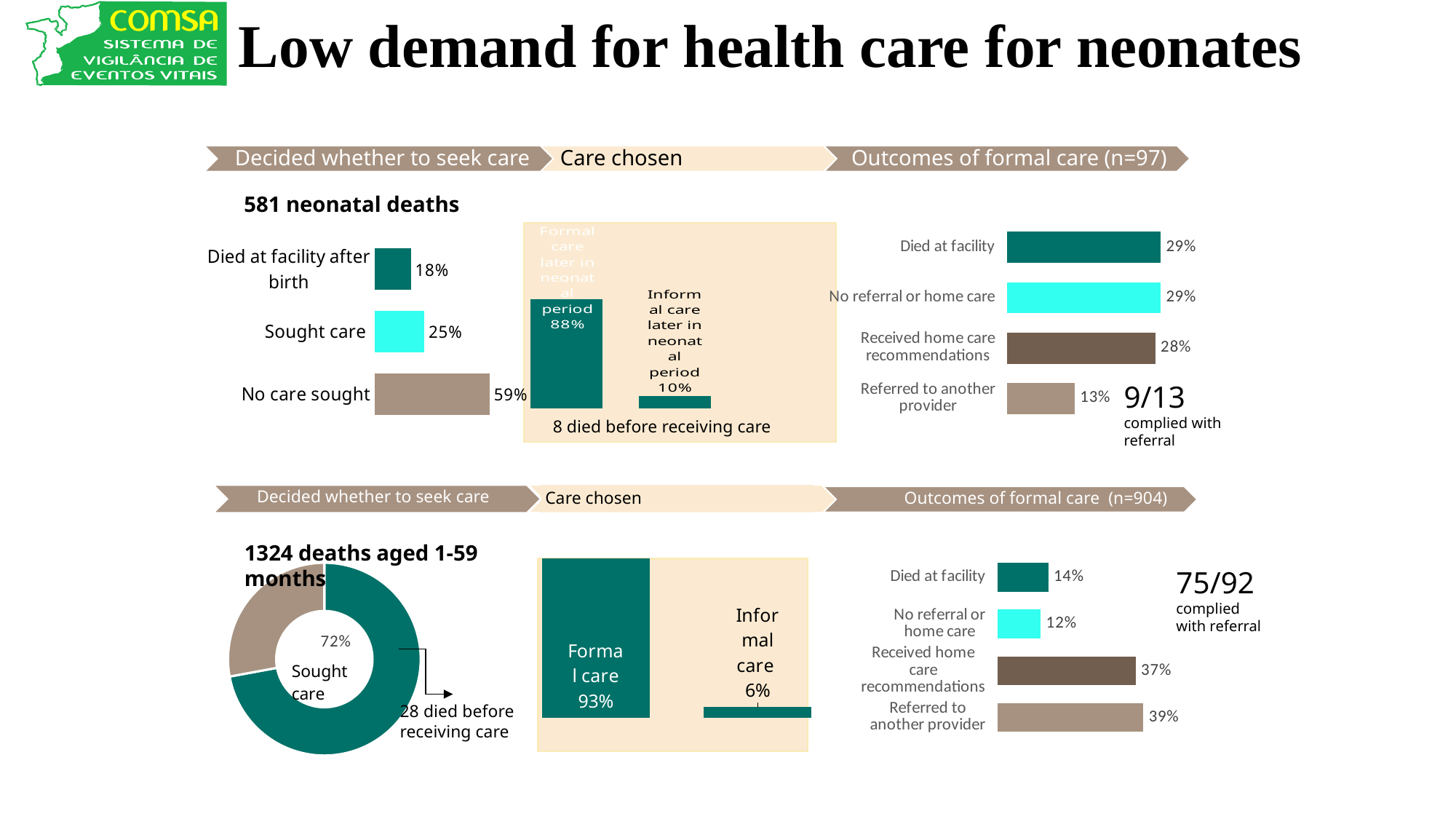
In the bottom-right chart 'Outcomes of formal care (n=904)', what is the difference between 'Referred to another provider' and 'No referral or home care'? 27% What type of chart is used for the 1324 deaths aged 1-59 months in the bottom-left? Donut (pie) chart In the top-left bar chart for 581 neonatal deaths, which category has the lowest value? Died at facility after birth In the bottom-middle 'Care chosen' chart for deaths aged 1-59 months, what percentage chose informal care? 6% In the bottom-right chart 'Outcomes of formal care (n=904)', which category has the highest value? Referred to another provider In the top-left bar chart for 581 neonatal deaths, what is the difference between 'No care sought' and 'Sought care'? 34% In the top-right chart 'Outcomes of formal care (n=97)', what percentage were referred to another provider? 13% In the bottom-left donut chart for 1324 deaths aged 1-59 months, what share sought care? 72% In the top-middle 'Care chosen' chart for neonates, what percentage chose formal care later in the neonatal period? 88% In the top-right chart 'Outcomes of formal care (n=97)', how many categories are shown? 4 In the top-left bar chart for 581 neonatal deaths, what percentage is shown for 'No care sought'? 59% In the bottom-right chart 'Outcomes of formal care (n=904)', which is larger: 'Died at facility' or 'Received home care recommendations'? Received home care recommendations